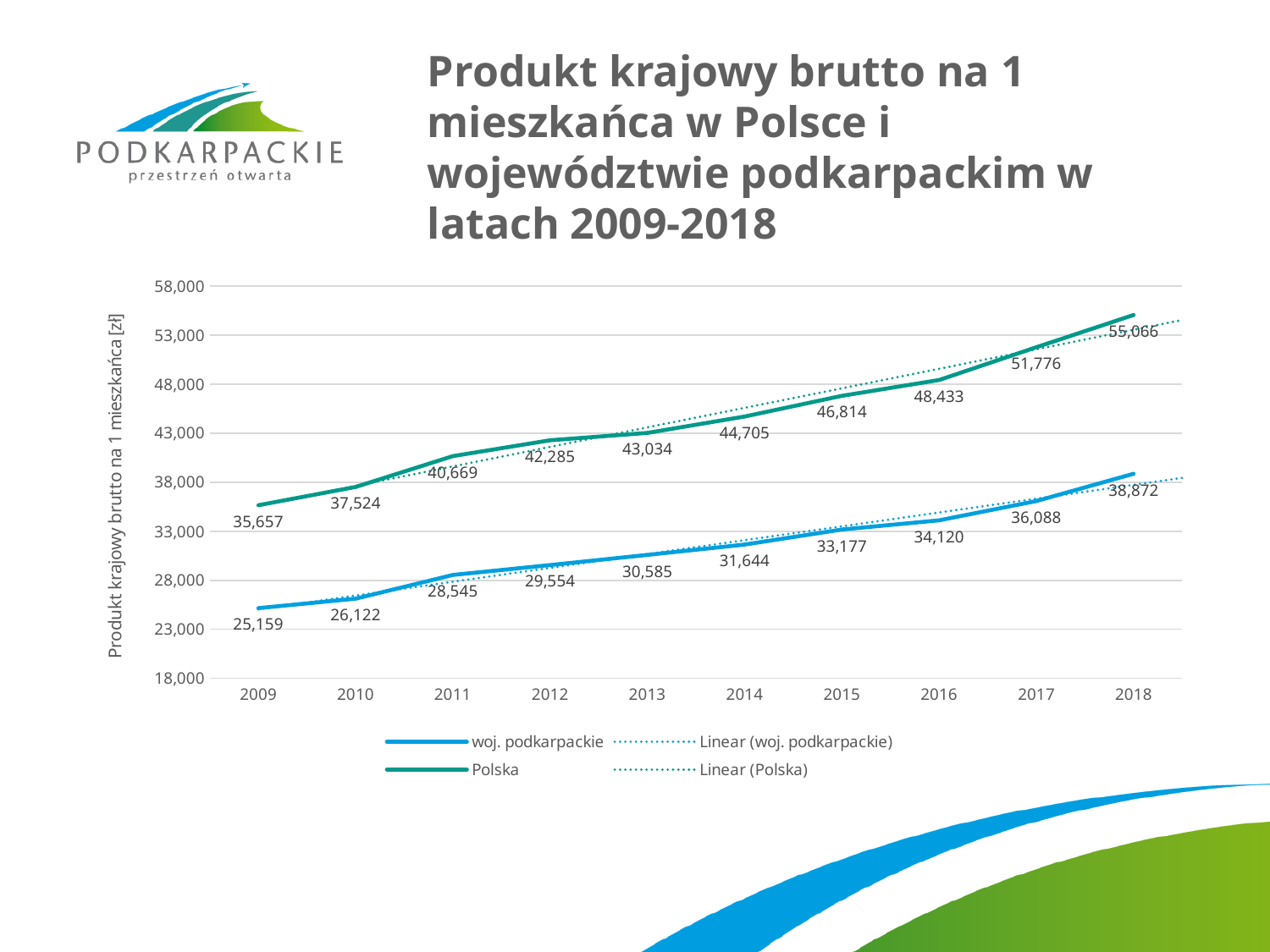
In which year is the value for woj. podkarpackie lowest? 2009 Is the value for Polska in 2017 greater or less than 48,000? greater What kind of chart is shown on the slide? line chart Which is larger in 2012: the value for Polska or for woj. podkarpackie? Polska In which year is the value for Polska highest? 2018 What is the difference between the Polska and woj. podkarpackie values in 2018? 16,194 How many entries does the legend list? 4 By how much did the woj. podkarpackie value increase from 2009 to 2018? 13,713 How many years are shown on the x axis? 10 What is the value for woj. podkarpackie in 2018? 38,872 What is the value for woj. podkarpackie in 2013? 30,585 What is the value for Polska in 2016? 48,433